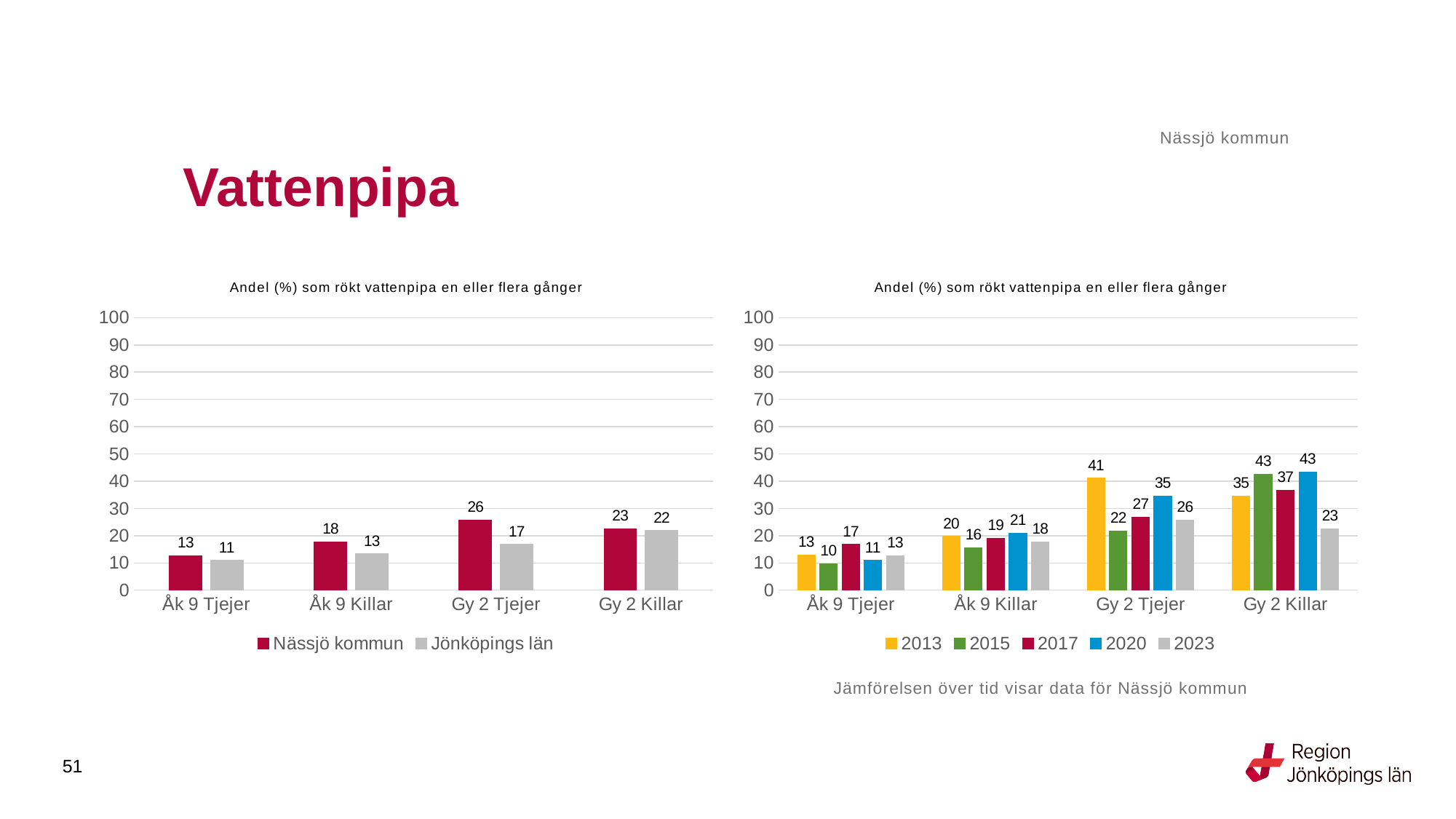
What kind of chart is the left chart? Bar chart In the right chart, which category has the lowest value for 2015? Åk 9 Tjejer In the left chart, which category has the highest value for Nässjö kommun? Gy 2 Tjejer In the right chart, what is the value for 2023 for Gy 2 Killar? 23 In the left chart, what is the value for Nässjö kommun for Gy 2 Tjejer? 26 In the right chart, how many categories are shown on the x axis? 4 In the right chart, how many series does the legend list? 5 In the left chart, what is the difference between Nässjö kommun and Jönköpings län for Gy 2 Tjejer? 9 In the left chart, what is the value for Jönköpings län for Åk 9 Killar? 13 In the right chart, which is larger for Åk 9 Killar: 2013 or 2015? 2013 In the right chart, what is the value for 2013 for Gy 2 Tjejer? 41 In the left chart, how many series does the legend list? 2